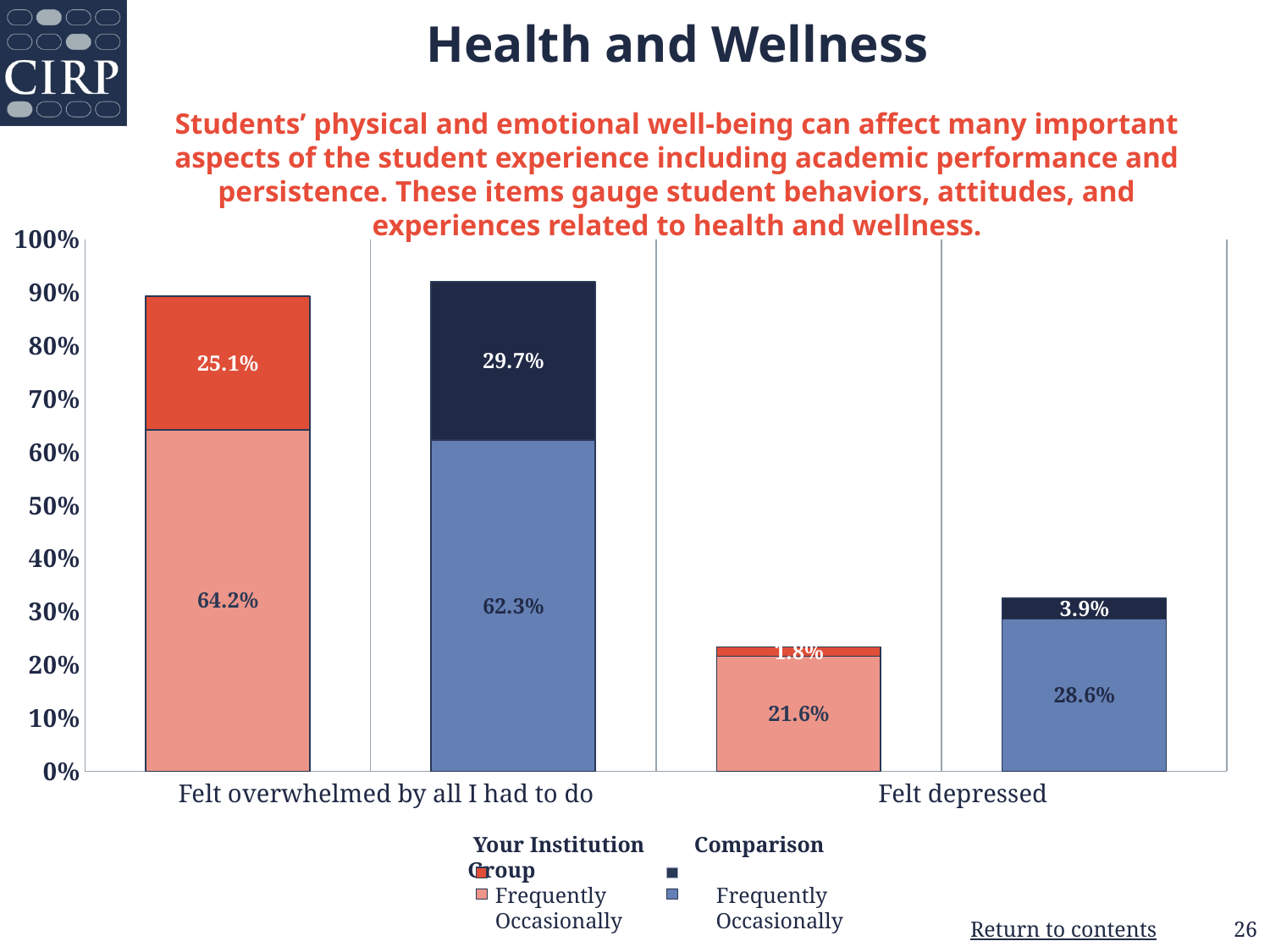
What is the total percentage (frequently plus occasionally) of Your Institution students who felt overwhelmed by all they had to do? 89.3% Which item has the lowest 'Frequently' percentage for Your Institution? Felt depressed What type of chart is shown on the slide? Stacked bar chart What is the difference between the Comparison Group and Your Institution in the percentage of students who frequently felt overwhelmed by all they had to do? 4.6% How many items (categories) are shown on the x axis of the chart? 2 What percentage of students at Your Institution reported occasionally feeling depressed? 21.6% How many series does the chart legend list? 4 Which group has a higher percentage of students who occasionally felt depressed, Your Institution or the Comparison Group? Comparison Group What is the total percentage (frequently plus occasionally) of Comparison Group students who felt depressed? 32.5% What percentage of students in the Comparison Group reported frequently feeling depressed? 3.9% What percentage of students in the Comparison Group reported occasionally feeling overwhelmed by all they had to do? 62.3% What percentage of students at Your Institution reported frequently feeling overwhelmed by all they had to do? 25.1%